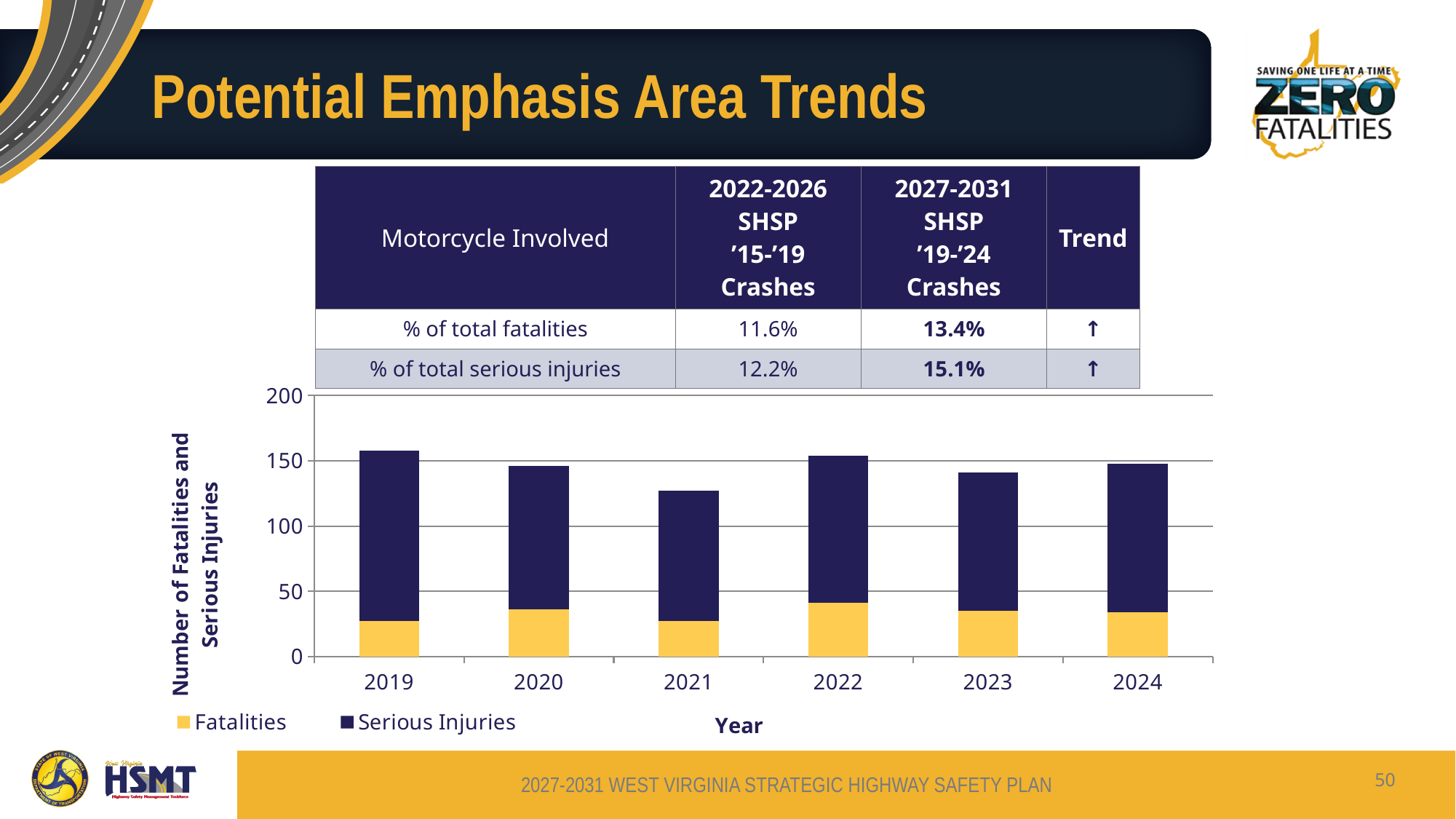
Is the total bar height for 2023 greater or less than 150? less Which year has the tallest stacked bar in the chart? 2019 Which year has the larger Fatalities segment, 2021 or 2022? 2022 What are the two series named in the chart legend? Fatalities and Serious Injuries Which year has the larger total bar, 2019 or 2021? 2019 Which year has the shortest stacked bar in the chart? 2021 How many series does the chart legend list? 2 How many years are shown on the x axis of the chart? 6 Is the total bar height for 2021 greater or less than 150? less Is the Fatalities value for 2022 greater or less than 50? less What kind of chart is shown on the slide? stacked bar chart